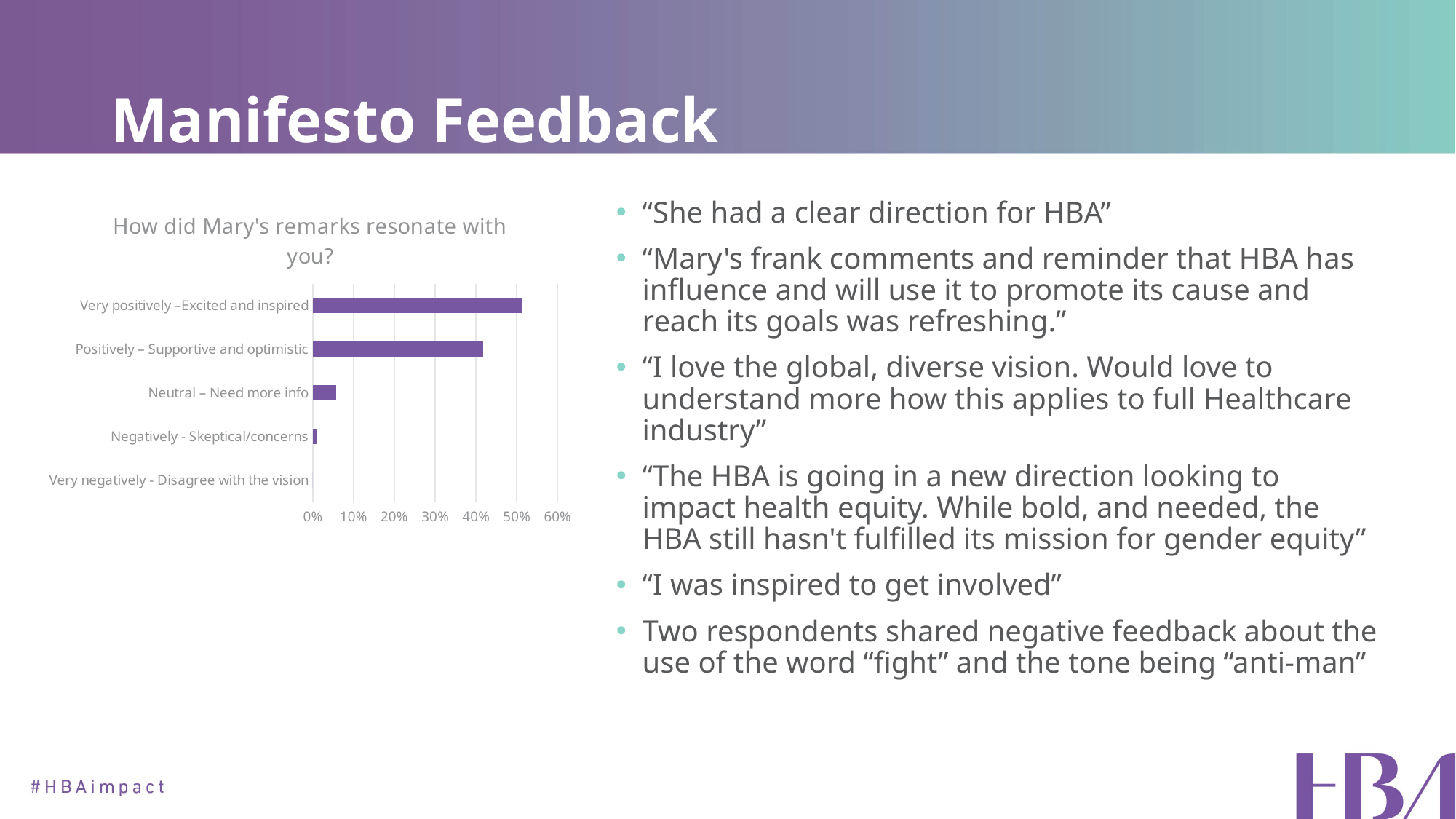
What kind of chart is shown on the slide? bar chart What colour are the bars in the chart? purple Is the value for "Neutral – Need more info" greater or less than 10%? less Is the value for "Positively – Supportive and optimistic" greater or less than 40%? greater Is the value for "Negatively - Skeptical/concerns" greater or less than 10%? less Which response category has the highest value? Very positively –Excited and inspired Do the values rise or fall going down the list of categories from "Very positively" to "Very negatively"? fall What is the title of the chart? How did Mary's remarks resonate with you? Which is larger: the value for "Positively – Supportive and optimistic" or the value for "Neutral – Need more info"? Positively – Supportive and optimistic How many response categories does the chart show? 5 Which response category has the lowest value? Very negatively - Disagree with the vision